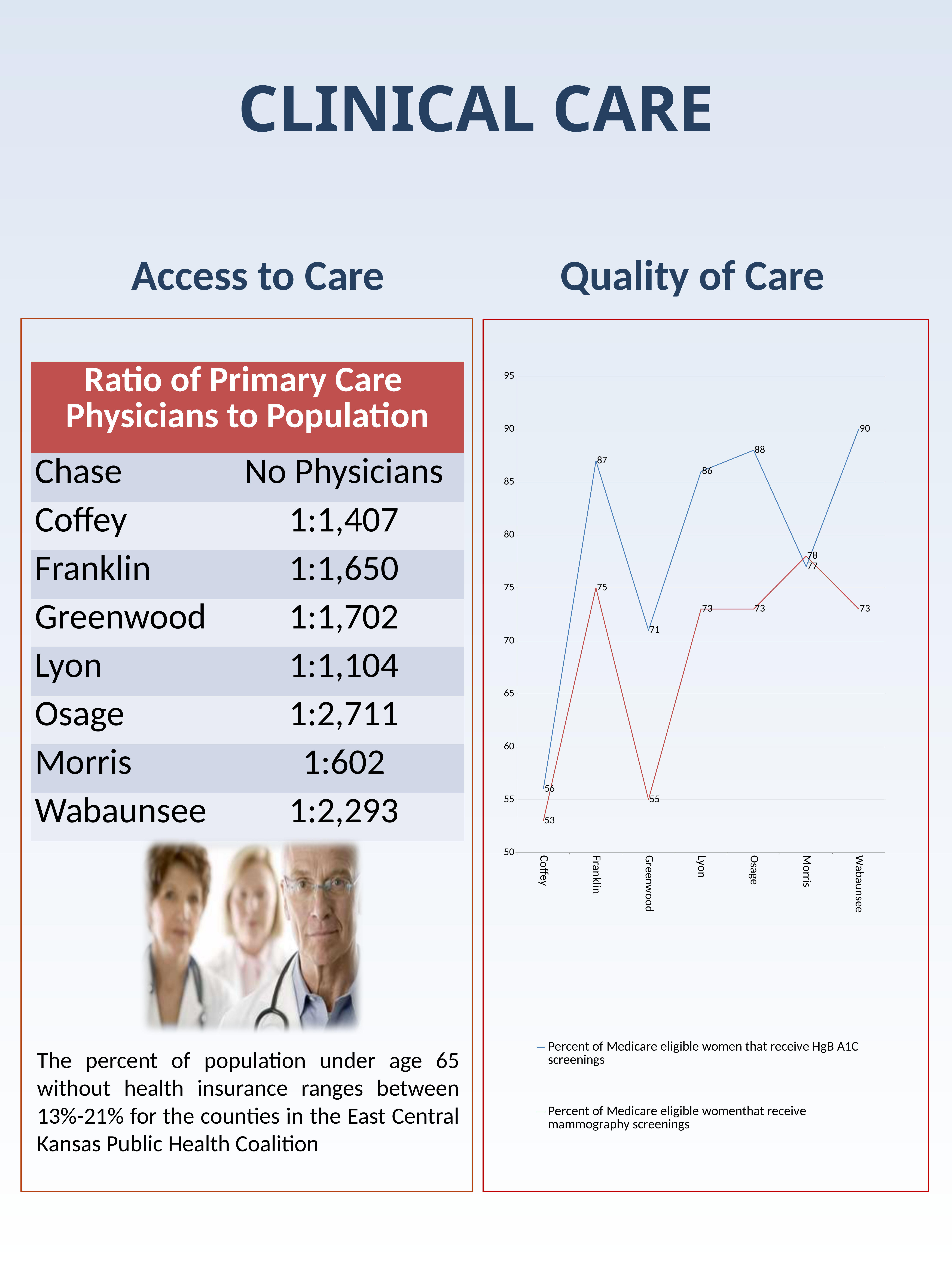
In the Quality of Care chart, which county has the highest percent of Medicare eligible women that receive HgB A1C screenings? Wabaunsee In the Quality of Care chart, what is the HgB A1C screening percent for Coffey? 56 How many series does the legend of the Quality of Care chart list? 2 In the Quality of Care chart, what is the difference between the HgB A1C screening percent and the mammography screening percent for Greenwood? 16 In the Quality of Care chart, what is the percent of Medicare eligible women that receive mammography screenings in Franklin? 75 In the Quality of Care chart, is the mammography screening percent for Morris greater or less than 75? greater In the Quality of Care chart, which county has the higher HgB A1C screening percent, Franklin or Lyon? Franklin In the Quality of Care chart, which colour line represents the percent of Medicare eligible women that receive mammography screenings? Red How many counties are plotted along the x axis of the Quality of Care chart? 7 In the Quality of Care chart, what is the percent of Medicare eligible women that receive HgB A1C screenings in Osage? 88 What kind of chart is shown in the Quality of Care panel? Line chart In the Quality of Care chart, which county has the lowest percent of Medicare eligible women that receive mammography screenings? Coffey